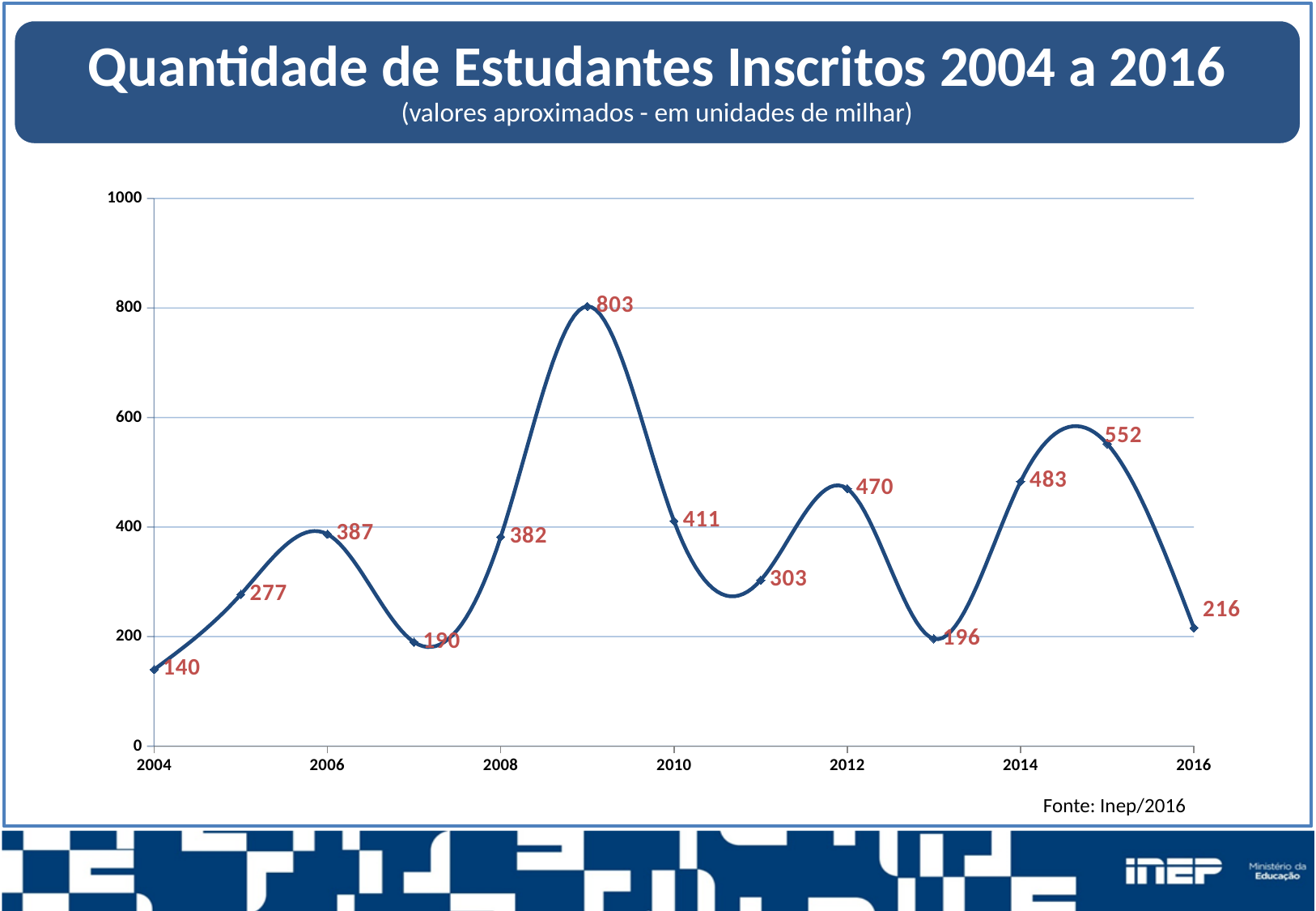
Do the values rise or fall from 2004 to 2006? rise What is the difference between the values for 2006 and 2004? 247 How many data points are plotted on the line? 13 What is the value for 2012? 470 What kind of chart is shown on the slide? line chart What is the highest value plotted on the chart? 803 What is the value for 2016? 216 Which year has the lowest value on the chart? 2004 What is the value for 2004? 140 What is the value for 2008? 382 What is the title of the chart? Quantidade de Estudantes Inscritos 2004 a 2016 Which is larger, the value for 2012 or the value for 2014? 2014